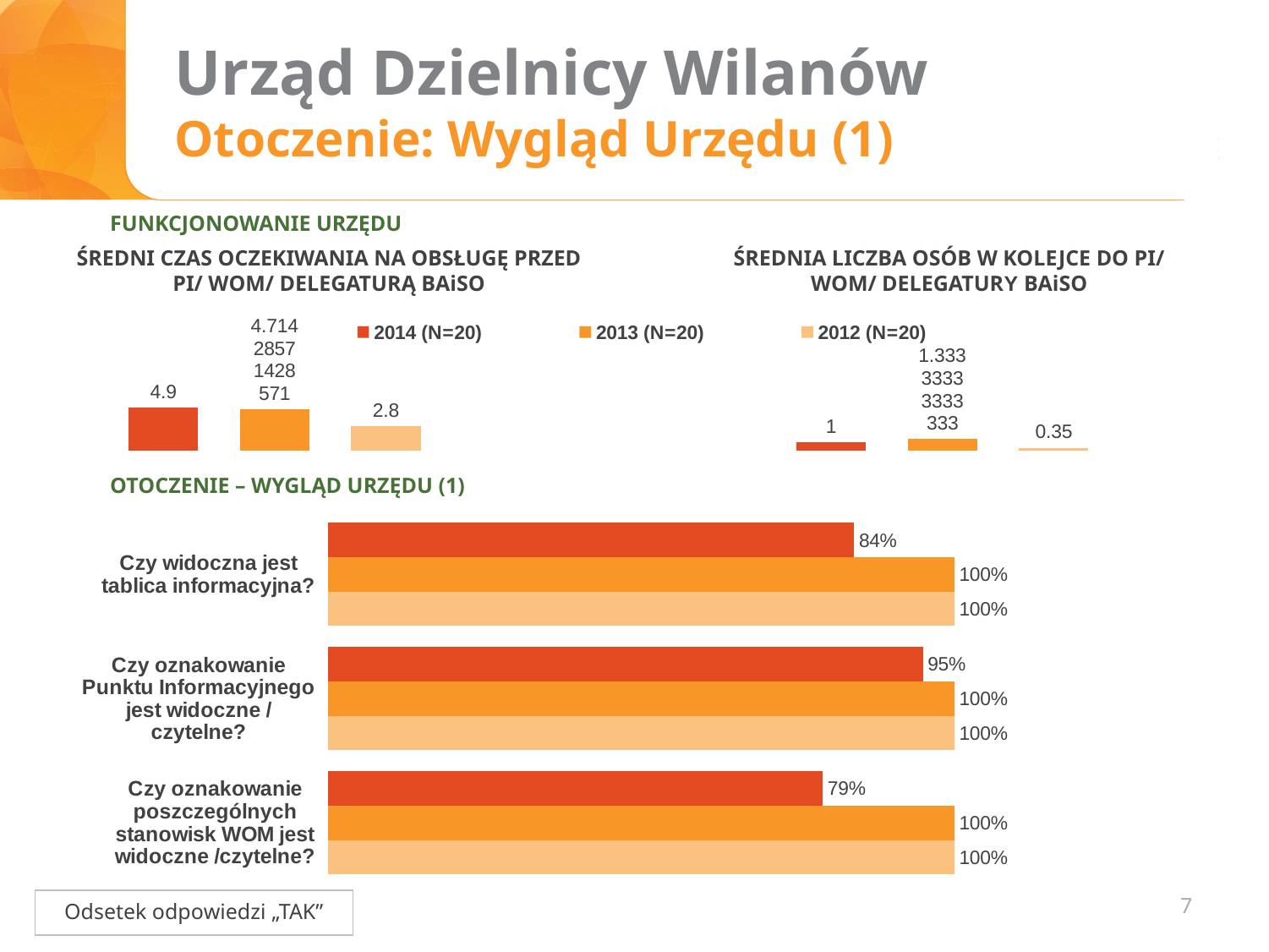
How many series does the legend list for the charts on this slide? 3 In the chart "Średni czas oczekiwania na obsługę przed PI/ WOM/ Delegaturą BAiSO", which year has the lowest value? 2012 In the chart "Średnia liczba osób w kolejce do PI/ WOM/ Delegatury BAiSO", what is the value for 2012? 0.35 In the chart "Średnia liczba osób w kolejce do PI/ WOM/ Delegatury BAiSO", which is larger, the value for 2014 or the value for 2012? 2014 In the bottom chart (Otoczenie – Wygląd Urzędu), what is the difference between the 2013 and 2014 values for "Czy widoczna jest tablica informacyjna?"? 16% In the bottom chart (Otoczenie – Wygląd Urzędu), what is the 2014 value for "Czy oznakowanie poszczególnych stanowisk WOM jest widoczne /czytelne?"? 79% In the chart "Średni czas oczekiwania na obsługę przed PI/ WOM/ Delegaturą BAiSO", what is the value for 2014? 4.9 In the bottom chart (Otoczenie – Wygląd Urzędu), what is the 2014 value for "Czy widoczna jest tablica informacyjna?"? 84% What type of chart is the bottom chart (Otoczenie – Wygląd Urzędu)? bar chart In the bottom chart (Otoczenie – Wygląd Urzędu), which question has the lowest 2014 value? Czy oznakowanie poszczególnych stanowisk WOM jest widoczne /czytelne? In the bottom chart (Otoczenie – Wygląd Urzędu), how many questions (categories) are shown? 3 In the bottom chart (Otoczenie – Wygląd Urzędu), what is the 2013 value for "Czy oznakowanie Punktu Informacyjnego jest widoczne / czytelne?"? 100%